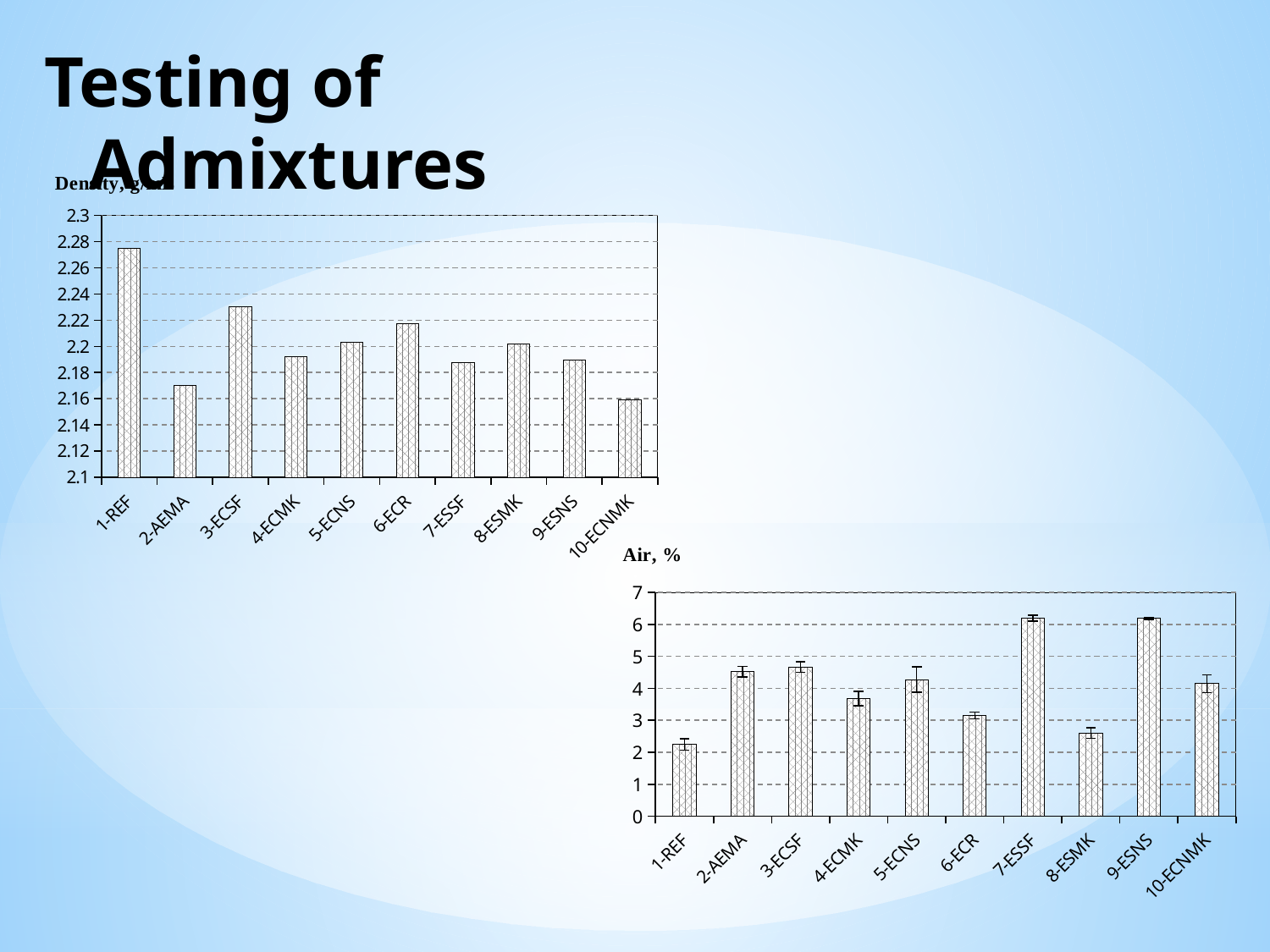
In the Density chart (top left), which category has the lowest density? 10-ECNMK In the Air, % chart (bottom right), is the value for 6-ECR greater or less than 4? less In the Density chart (top left), is the value for 2-AEMA greater or less than 2.2? less In the Density chart (top left), is the value for 3-ECSF greater or less than 2.2? greater In the Density chart (top left), which category has the highest density? 1-REF What kind of chart is the Density chart (top left)? bar chart In the Air, % chart (bottom right), which is larger, the value for 2-AEMA or the value for 4-ECMK? 2-AEMA How many categories are plotted in the Density chart (top left)? 10 In the Density chart (top left), which is larger, the value for 6-ECR or the value for 4-ECMK? 6-ECR In the Air, % chart (bottom right), which category has the lowest air content? 1-REF How many categories are plotted in the Air, % chart (bottom right)? 10